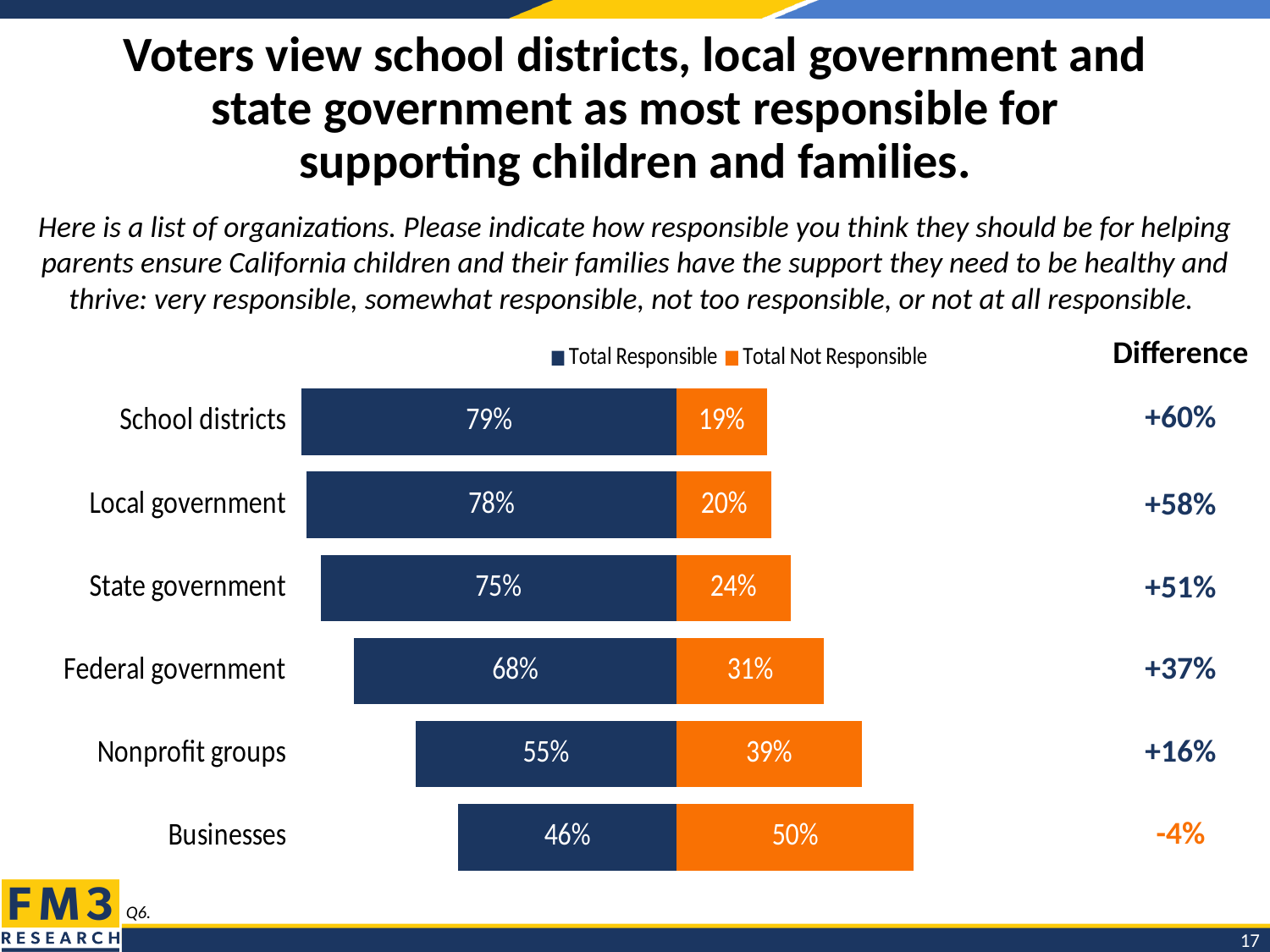
What is the Difference value shown for Federal government? +37% Which colour represents Total Not Responsible in the chart? Orange How many categories are shown in the chart? 6 Which category has the highest Total Responsible value? School districts What kind of chart is shown on the slide? Bar chart What is the Total Not Responsible value for Federal government? 31% What is the Total Responsible value for School districts? 79% What is the difference between the Total Responsible values for State government and Nonprofit groups? 20% What is the Total Not Responsible value for Businesses? 50% Which category has the lowest Total Responsible value? Businesses How many series does the legend list? 2 Which is larger: the Total Not Responsible value for Nonprofit groups or for Local government? Nonprofit groups